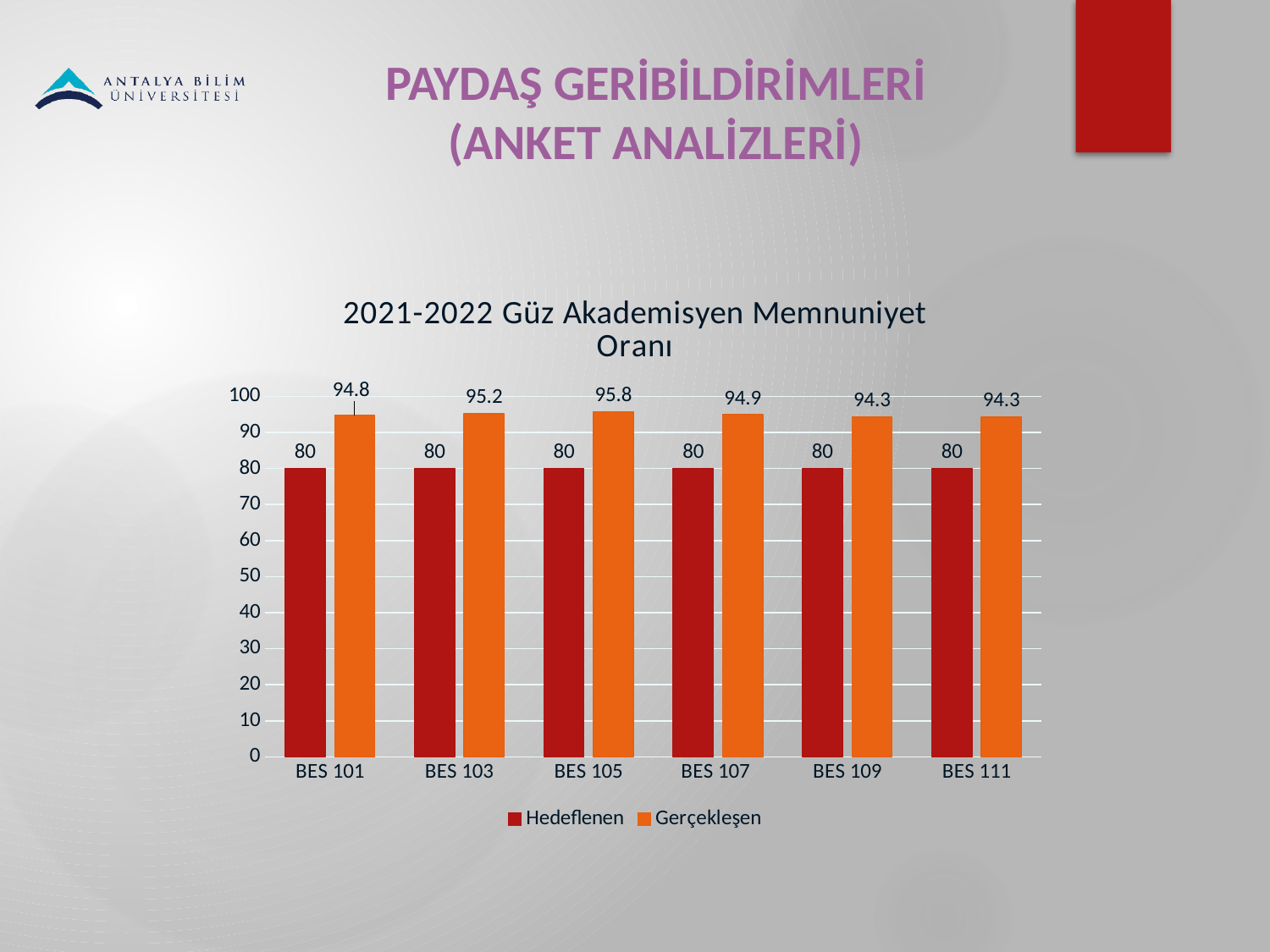
What is the difference between the Gerçekleşen and Hedeflenen values for BES 103? 15.2 Is the Gerçekleşen value for BES 111 greater or less than 90? greater Which course has the highest Gerçekleşen value? BES 105 What is the Gerçekleşen value for BES 105? 95.8 Which is larger for BES 109: the Hedeflenen value or the Gerçekleşen value? Gerçekleşen What kind of chart is shown on the slide? bar chart How many courses are shown on the x axis? 6 What is the Gerçekleşen value for BES 101? 94.8 How many series does the legend list? 2 Which colour represents the Gerçekleşen series? orange What is the title of the chart? 2021-2022 Güz Akademisyen Memnuniyet Oranı What is the Hedeflenen value for BES 107? 80